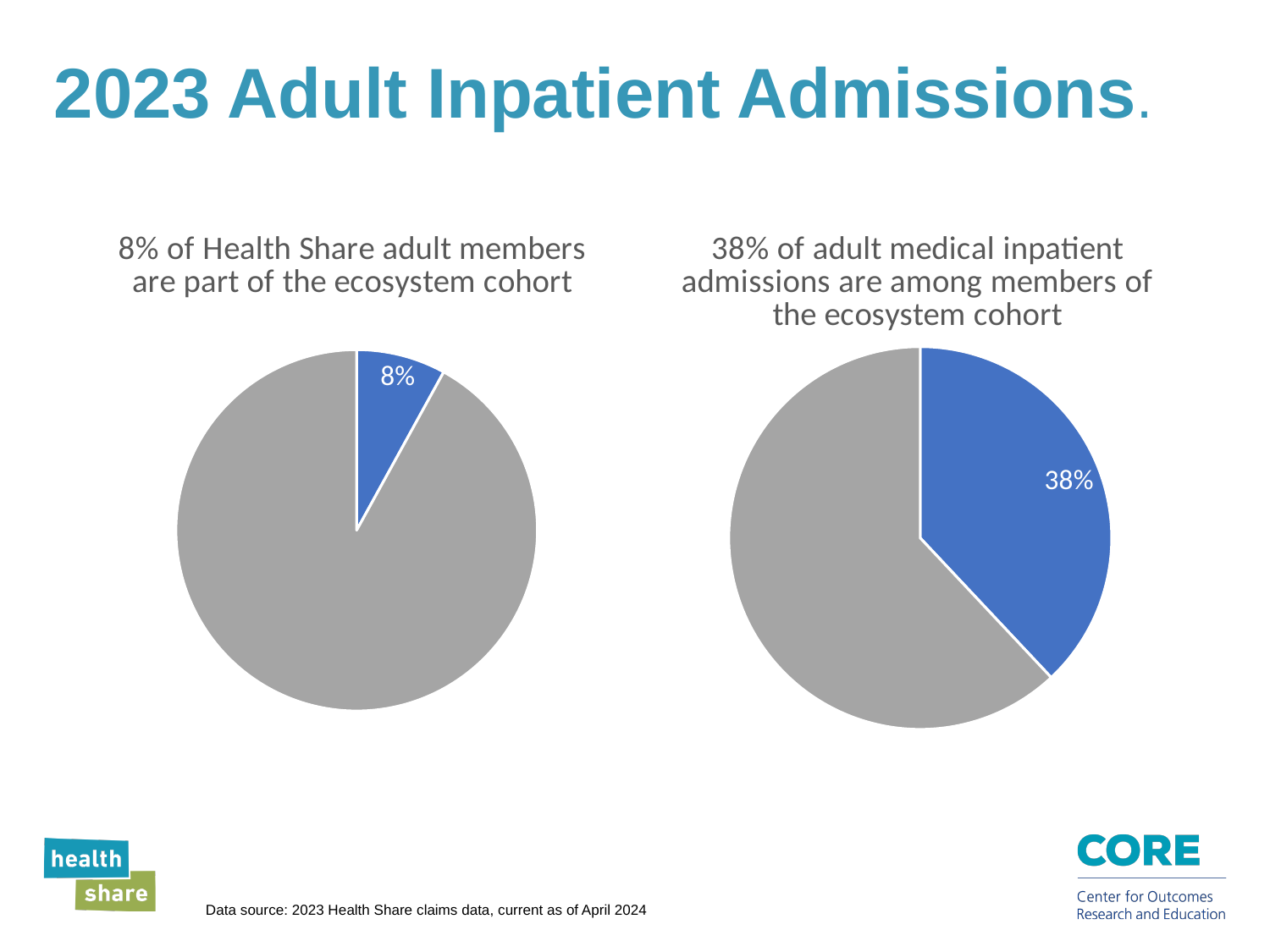
In the left pie chart, what percentage of Health Share adult members are part of the ecosystem cohort? 8% What is the difference between the labeled share in the right pie chart (38%) and the labeled share in the left pie chart (8%)? 30 percentage points What colour is the slice labeled 38% in the right pie chart? Blue How many slices does the right pie chart have? 2 How many pie charts are shown on the slide? 2 In the right pie chart, what share of adult medical inpatient admissions are among members of the ecosystem cohort? 38% In the right pie chart, is the blue slice greater or less than half of the pie? less What is the title of the slide containing the two pie charts? 2023 Adult Inpatient Admissions Which chart has the larger labeled blue slice, the left chart (adult members) or the right chart (inpatient admissions)? The right chart (inpatient admissions) What kind of chart is used on this slide to show the ecosystem cohort figures? Pie chart In the left pie chart, is the labeled slice greater or less than 10%? less How many slices does the left pie chart have? 2